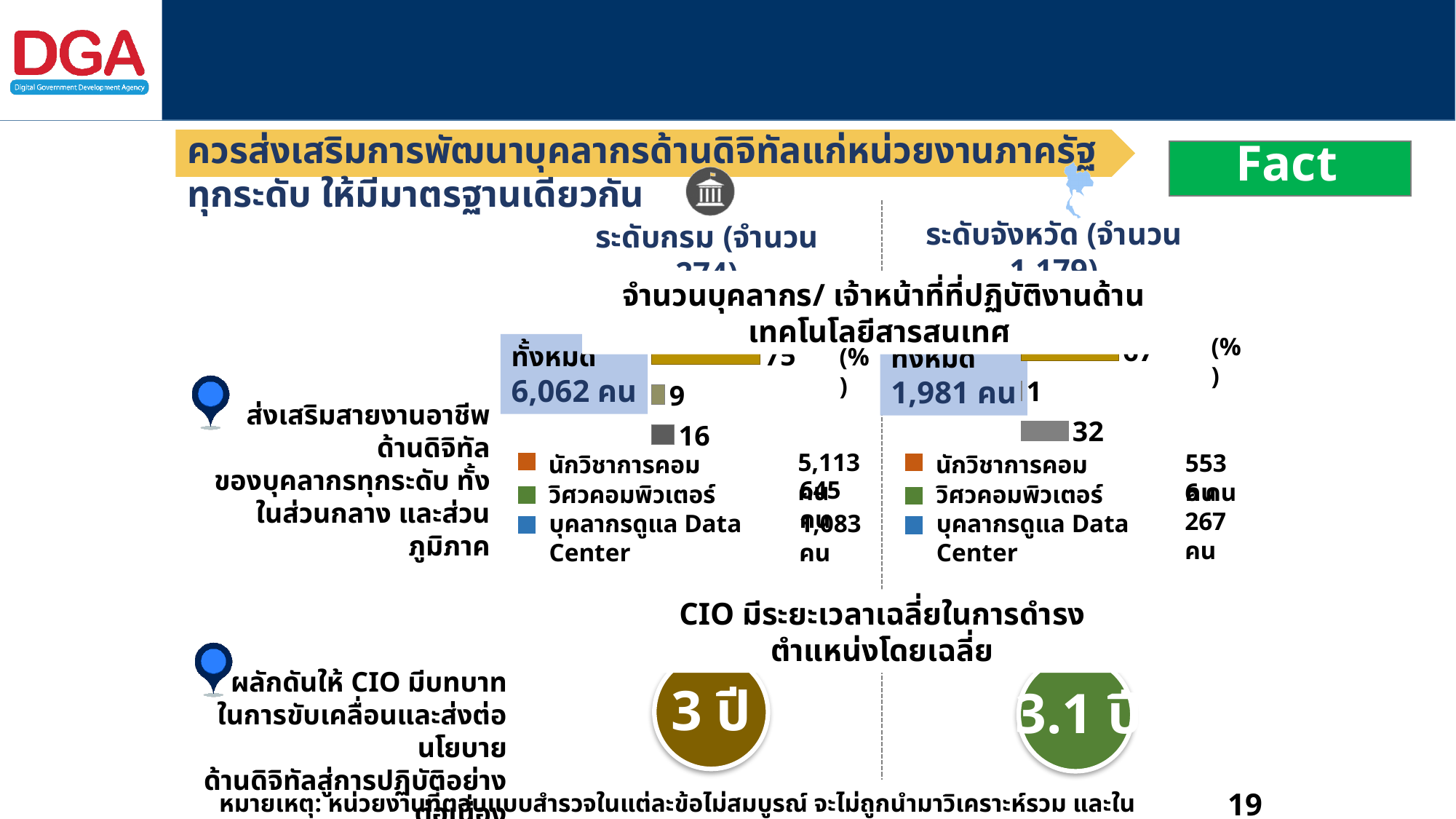
In the department-level (ระดับกรม) chart, what is the total number of personnel shown (ทั้งหมด)? 6,062 คน In the department-level (ระดับกรม) chart, what is the difference between the bar labels for บุคลากรดูแล Data Center and วิศวคอมพิวเตอร์? 7 In the province-level (ระดับจังหวัด) chart, what percentage label is shown on the bar for บุคลากรดูแล Data Center? 32 In the province-level (ระดับจังหวัด) chart, how many นักวิชาการคอม are listed in the legend? 553 คน In the department-level (ระดับกรม) chart, what percentage label is shown on the bar for บุคลากรดูแล Data Center? 16 In the province-level (ระดับจังหวัด) chart, what is the total number of personnel shown (ทั้งหมด)? 1,981 คน What kind of chart is used to show the number of IT personnel at the department level (ระดับกรม)? bar chart In the department-level (ระดับกรม) chart, what percentage label is shown on the bar for วิศวคอมพิวเตอร์? 9 In the department-level (ระดับกรม) chart, which category has the longest bar? นักวิชาการคอม In the province-level (ระดับจังหวัด) chart, how many บุคลากรดูแล Data Center are listed in the legend? 267 คน In the department-level (ระดับกรม) chart, how many นักวิชาการคอม are listed in the legend? 5,113 คน In the department-level (ระดับกรม) chart, how many entries does the legend list? 3